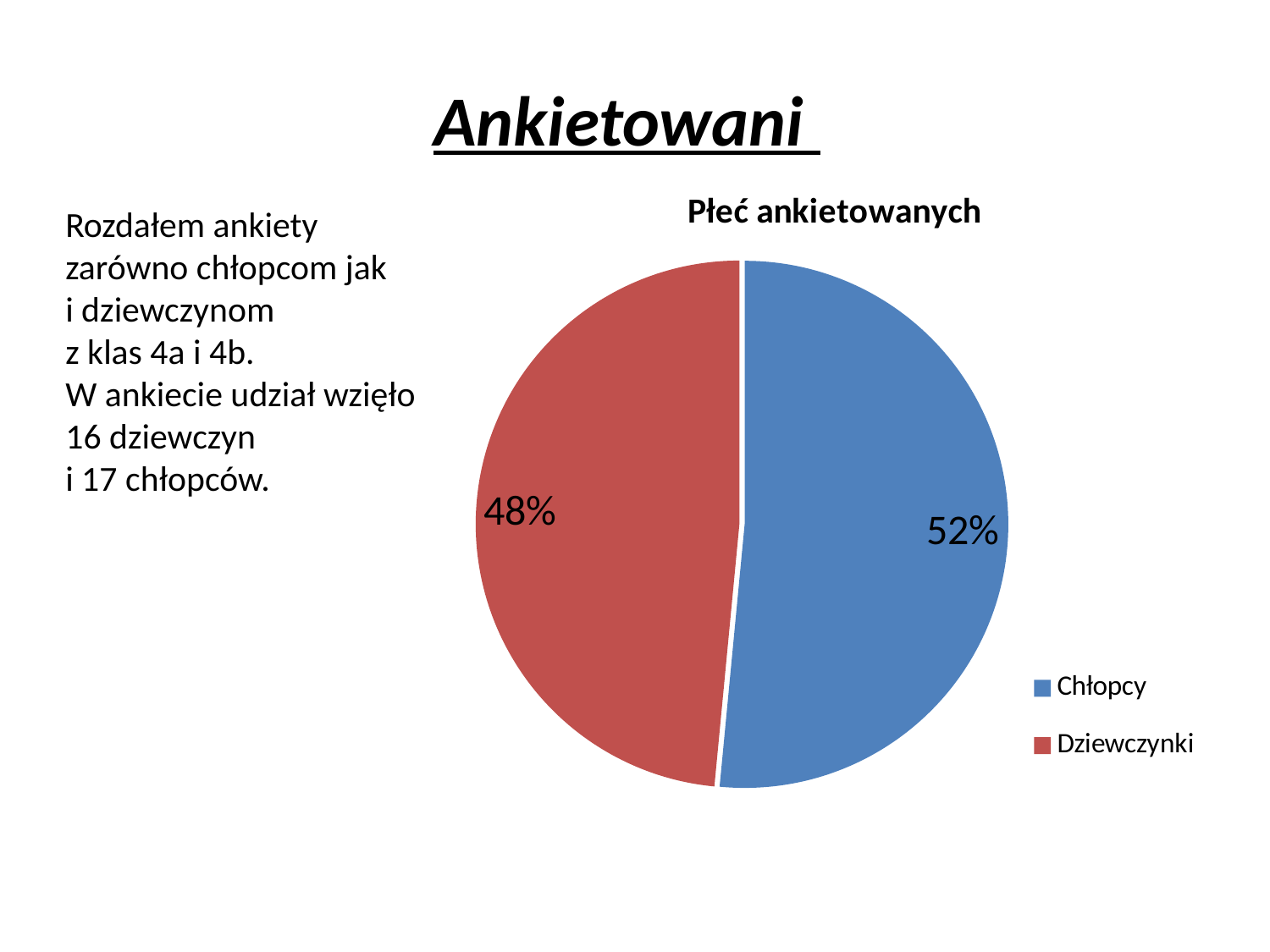
What is the title of the chart? Płeć ankietowanych What share of the pie does Dziewczynki have? 48% What share of the pie does Chłopcy have? 52% Which category has the largest slice of the pie? Chłopcy What kind of chart is shown on the slide? Pie chart Which slice is larger, Chłopcy or Dziewczynki? Chłopcy Which category has the smallest slice of the pie? Dziewczynki How many categories does the pie chart show? 2 Which colour represents Dziewczynki in the chart? Red What is the difference in percentage points between the Chłopcy and Dziewczynki slices? 4